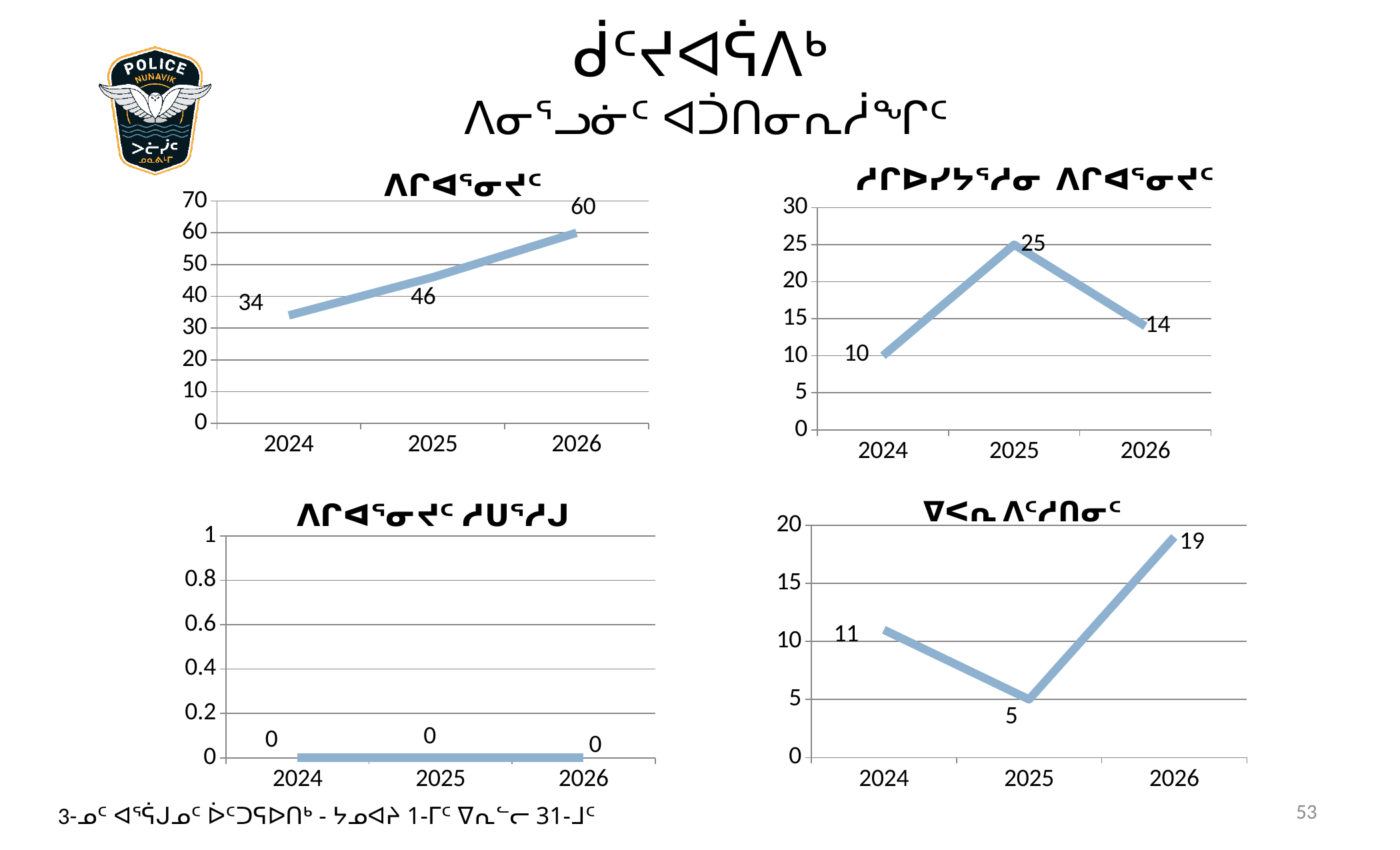
In the top-right chart, what is the difference between the 2025 and 2026 values? 11 In the bottom-right chart, what is the value for 2024? 11 What type of chart is the top-right chart? line chart How many data points are plotted in the bottom-right chart? 3 In the bottom-left chart, what is the value for 2026? 0 In the top-left chart, what is the difference between the 2026 and 2024 values? 26 In the top-left chart, what is the value for 2025? 46 In the top-right chart, which year has the lowest value? 2024 In the top-left chart, do the values rise or fall from 2024 to 2026? rise In the top-left chart, which year has the highest value? 2026 In the bottom-right chart, which is larger, the value for 2024 or the value for 2025? 2024 In the top-right chart, what is the value for 2025? 25